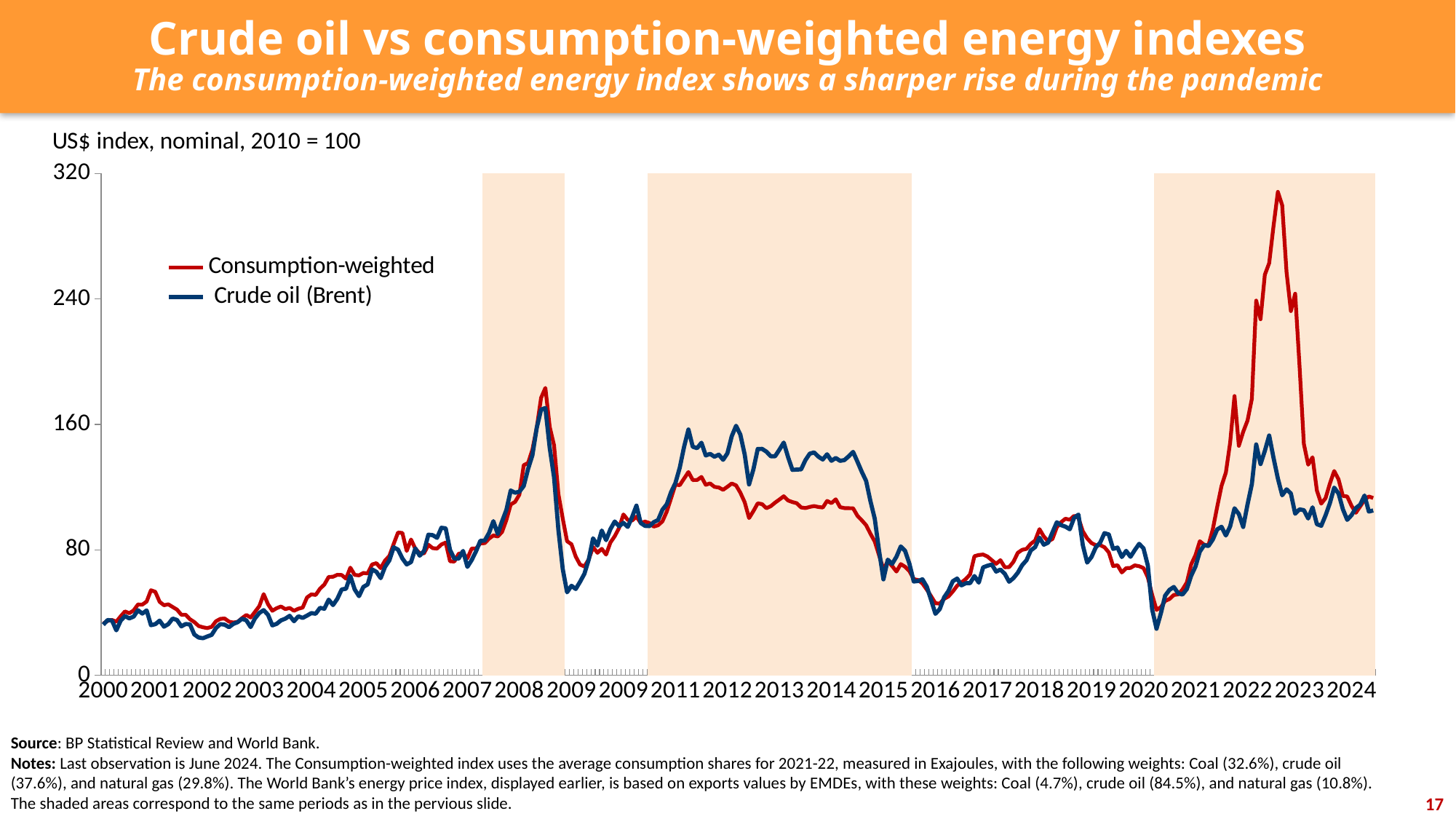
Do the values of the Crude oil (Brent) index rise or fall from 2002 to early 2008? rise Which two series are listed in the legend? Consumption-weighted and Crude oil (Brent) During 2012 to 2014, which series is higher: Consumption-weighted or Crude oil (Brent)? Crude oil (Brent) Is the value of the Crude oil (Brent) index during 2013 greater or less than 80? greater What is the unit label shown above the chart? US$ index, nominal, 2010 = 100 How many series does the legend list? 2 Which series reaches the highest value anywhere on the chart? Consumption-weighted At the 2022 peak, which series is higher: Consumption-weighted or Crude oil (Brent)? Consumption-weighted What kind of chart is shown on the slide? line chart Is the peak value of the Consumption-weighted index in 2022 greater or less than 240? greater Is the value of the Consumption-weighted index at the start of 2000 greater or less than 80? less